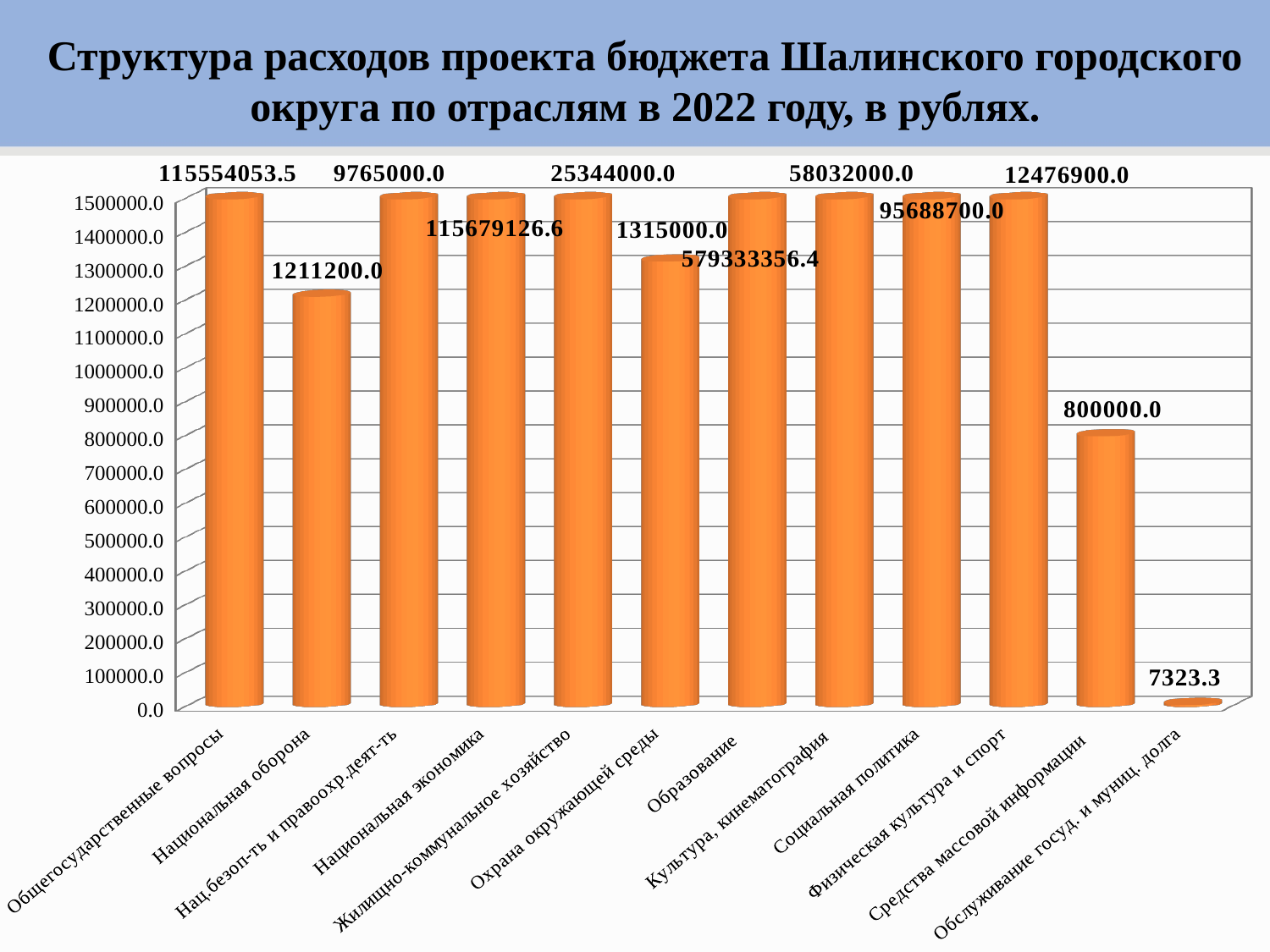
What is the value for Национальная оборона? 1211200.0 What kind of chart is shown on the slide? bar chart What is the value for Средства массовой информации? 800000.0 What is the difference between the values for Национальная оборона and Средства массовой информации? 411200.0 Is the value for Средства массовой информации greater or less than 1000000.0? less Which category has the lowest value? Обслуживание госуд. и муниц. долга Which category has the highest value? Образование How many categories are shown on the x axis? 12 What is the value for Образование? 579333356.4 What year does the chart title refer to? 2022 What is the value for Социальная политика? 95688700.0 Which is larger, the value for Культура, кинематография or the value for Жилищно-коммунальное хозяйство? Культура, кинематография